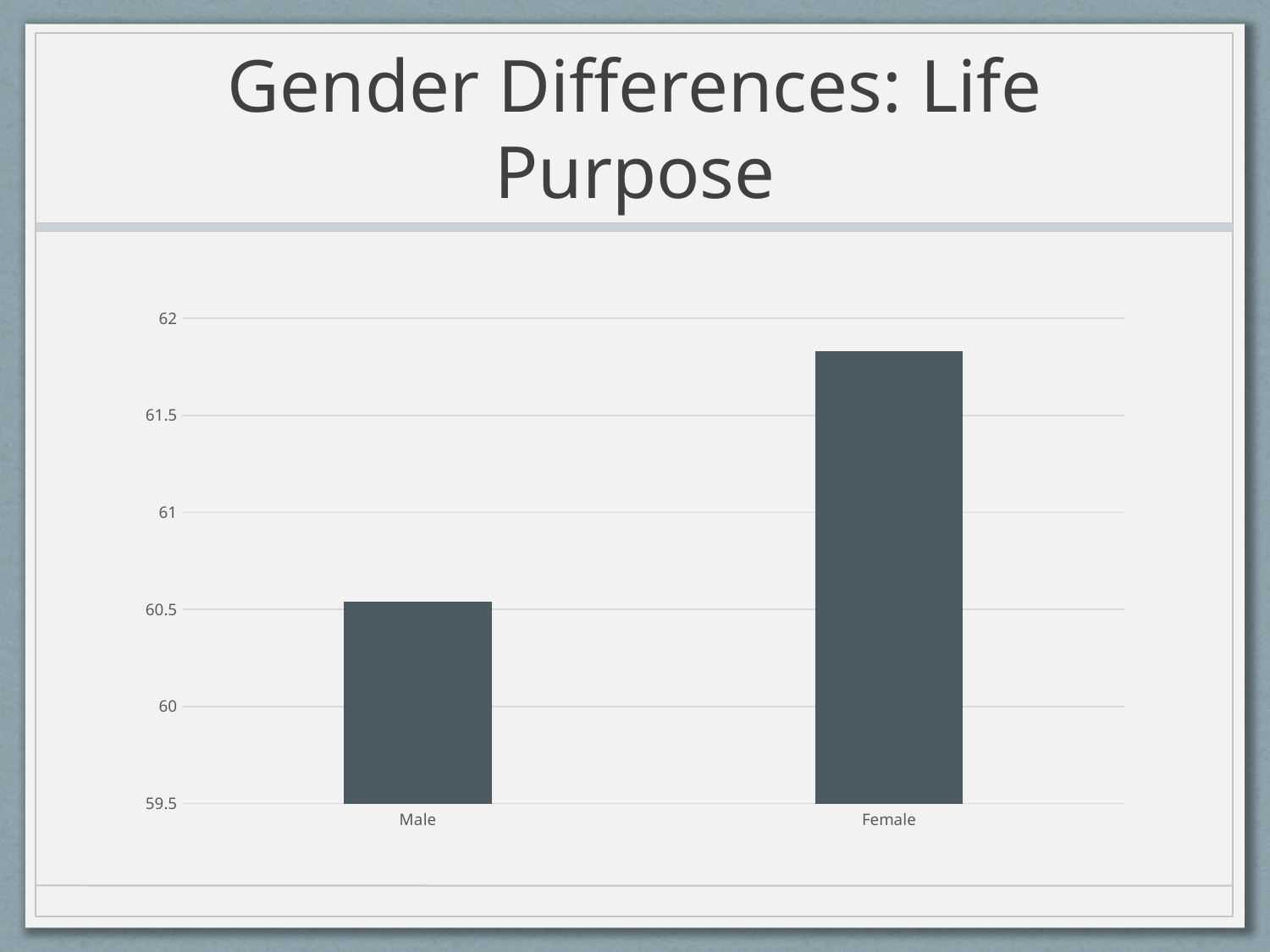
What is the title of the slide containing the chart? Gender Differences: Life Purpose Which category has the lowest value? Male Is the value for Male greater or less than 60? greater Which category has the highest value? Female Is the value for Male greater or less than 61? less What kind of chart is shown on the slide? bar chart How many categories are plotted on the chart? 2 Is the value for Female greater or less than 61.5? greater What is the lowest value shown on the vertical axis? 59.5 Which is larger, the value for Male or the value for Female? Female